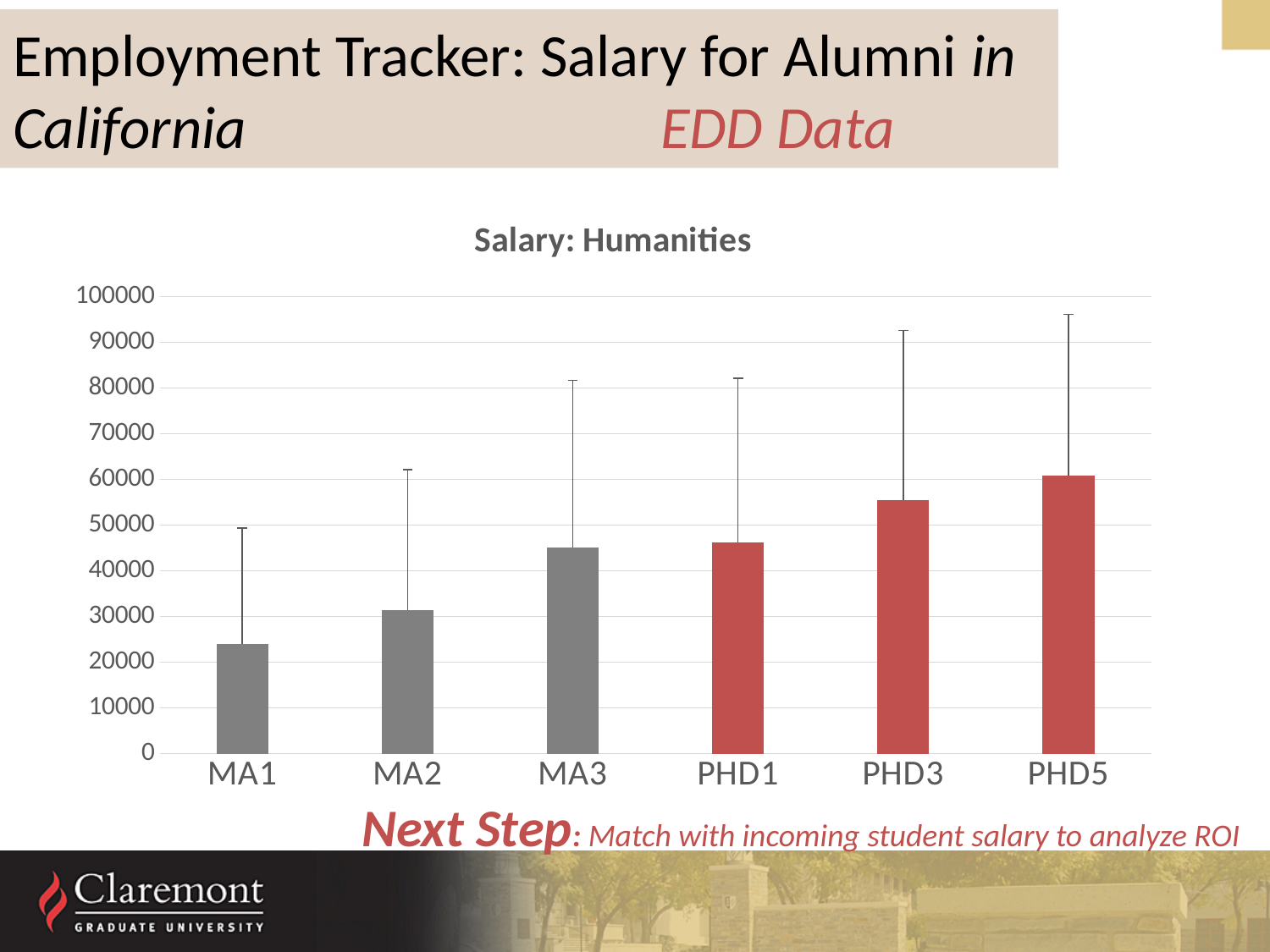
Which category has the highest bar in the chart? PHD5 Which categories are shown with red bars in the chart? PHD1, PHD3, PHD5 Is the value for MA1 greater or less than 30000? less Is the value for PHD5 greater or less than 50000? greater Which is larger, the value for MA2 or the value for PHD3? PHD3 What is the title of the chart? Salary: Humanities Is the value for MA3 greater or less than 40000? greater How many categories are shown on the x axis of the chart? 6 Do the bar values rise or fall from MA1 to PHD5 along the x axis? rise What kind of chart is shown on the slide? bar chart Which category has the lowest bar in the chart? MA1